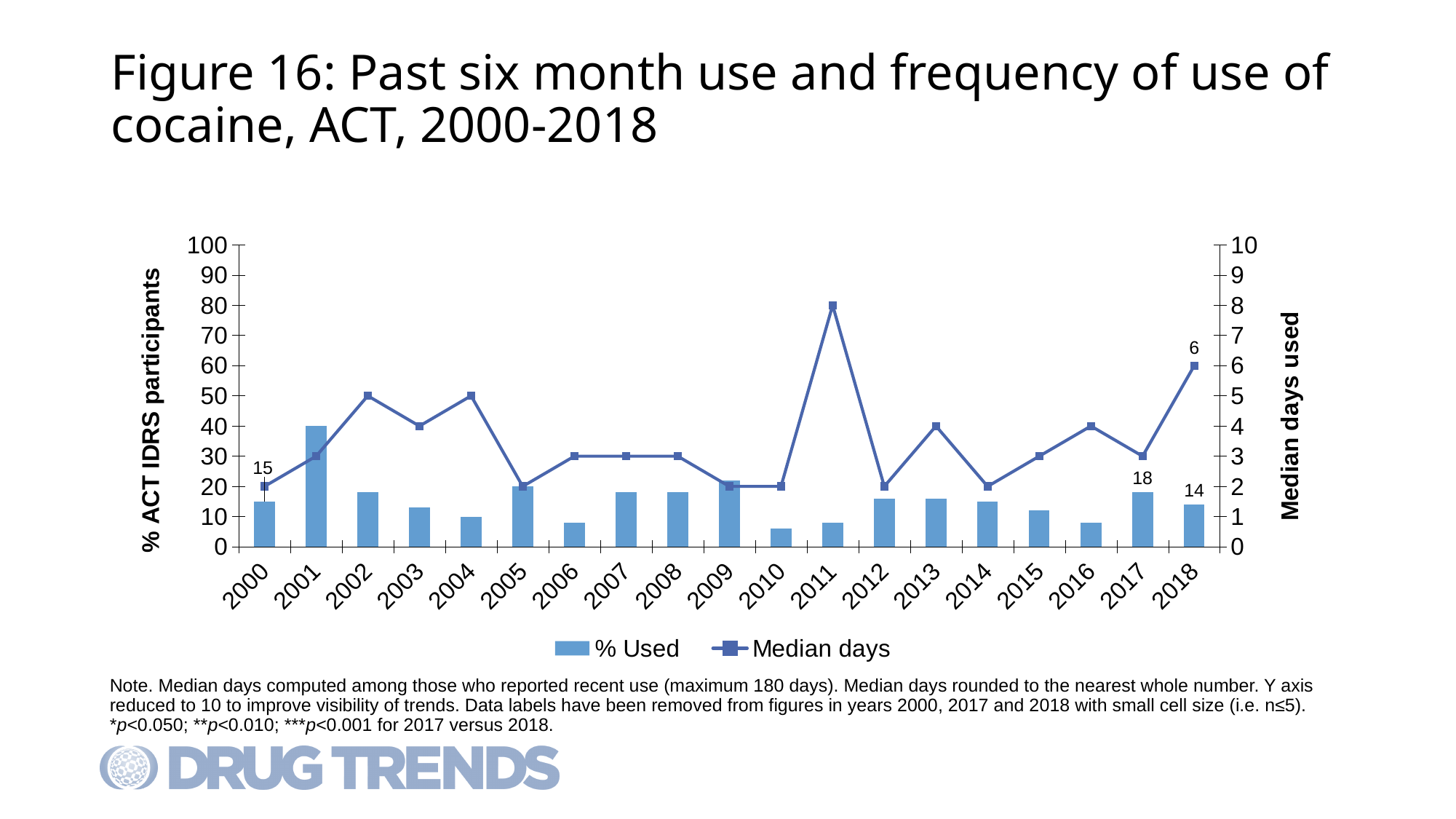
Which year has the highest Median days value? 2011 What is the % Used value for 2018? 14 Which year has a larger % Used value, 2000 or 2018? 2000 How many series does the legend list? 2 Which year has the highest % Used? 2001 What is the difference between the % Used values for 2017 and 2018? 4 Is the % Used value for 2001 greater or less than 30? greater How many years are shown on the x axis? 19 What is the % Used value for 2000? 15 What is the Median days value for 2011? 8 What is the % Used value for 2017? 18 What is the Median days value for 2018? 6